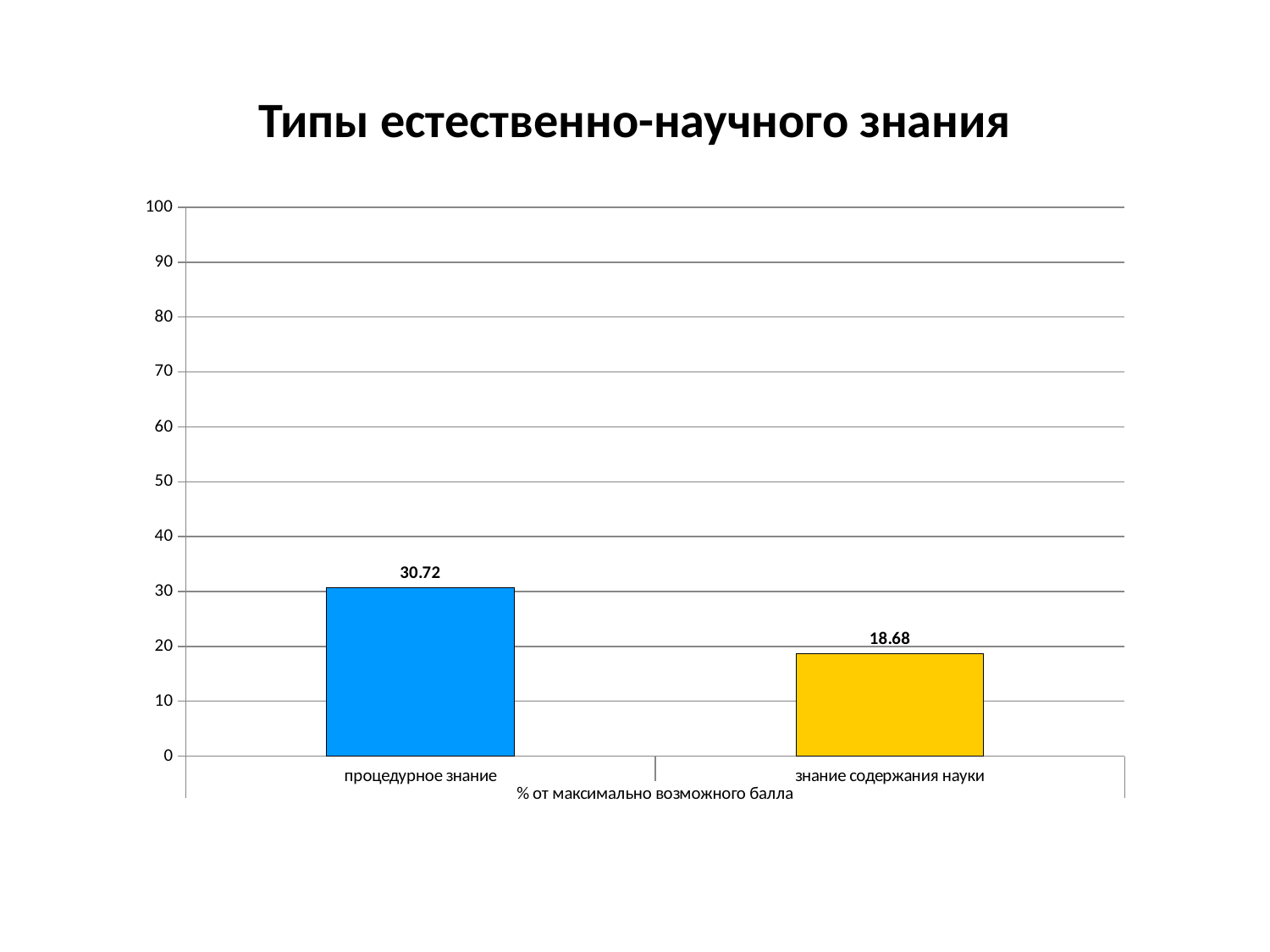
How many categories are shown in the chart? 2 Is the value for процедурное знание greater or less than 40? less What is the value for процедурное знание? 30.72 What is the label shown below the category axis? % от максимально возможного балла What is the title of the chart? Типы естественно-научного знания Which category has the lowest value? знание содержания науки Which is larger: the value for процедурное знание or the value for знание содержания науки? процедурное знание What is the difference between the values for процедурное знание and знание содержания науки? 12.04 What kind of chart is shown on the slide? bar chart What is the value for знание содержания науки? 18.68 Is the value for знание содержания науки greater or less than 10? greater Which category has the highest value? процедурное знание